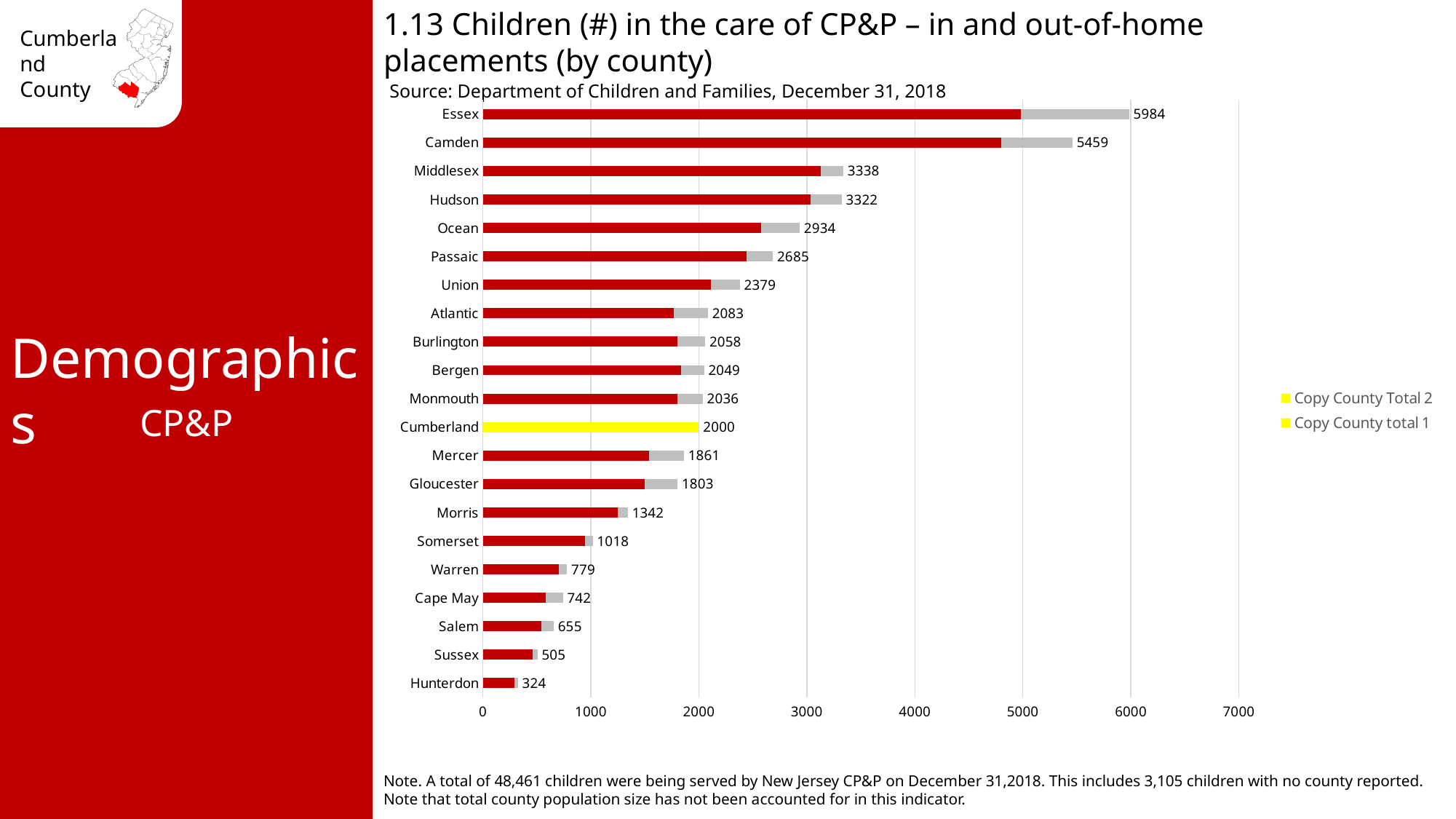
What is the value shown for Cumberland county? 2000 What kind of chart is shown on the slide? Bar chart Which county has the lowest number of children in the care of CP&P? Hunterdon Which county's bar is highlighted in yellow? Cumberland How many entries does the legend list? 2 Which county has a larger value, Ocean or Passaic? Ocean What is the total number of children in the care of CP&P for Essex county? 5984 Which county has the highest number of children in the care of CP&P? Essex How many counties are shown on the chart? 21 What is the difference between the values for Essex and Camden? 525 What is the value shown for Hunterdon county? 324 Is the value for Morris greater or less than 1000? greater